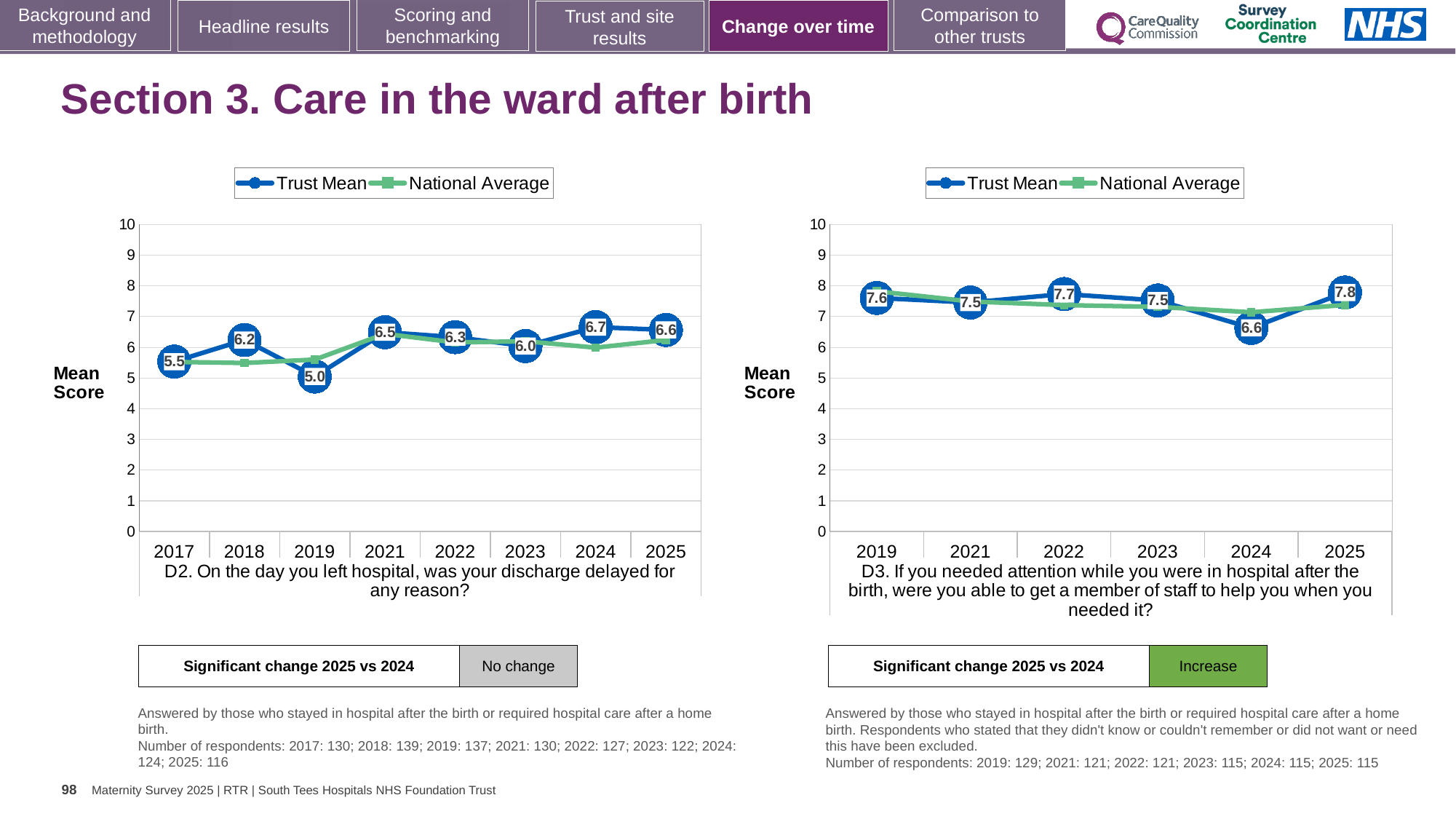
In the D2 chart (left), what is the Trust Mean for 2019? 5.0 In the D2 chart (left), is the National Average for 2017 greater or less than 6? less In the D2 chart (left), which year has the highest Trust Mean? 2024 In the D2 chart (left), what is the Trust Mean for 2024? 6.7 In the D3 chart (right), what is the Trust Mean for 2025? 7.8 What kind of chart is the D2 chart (left)? Line chart In the D3 chart (right), is the Trust Mean higher in 2022 or in 2023? 2022 In the D3 chart (right), which year has the lowest Trust Mean? 2024 In the D2 chart (left), what is the difference between the Trust Mean for 2018 and 2019? 1.2 In the D3 chart (right), what is the difference between the Trust Mean for 2025 and 2024? 1.2 How many series does the legend of the D2 chart (left) list? 2 How many years are shown on the x axis of the D3 chart (right)? 6